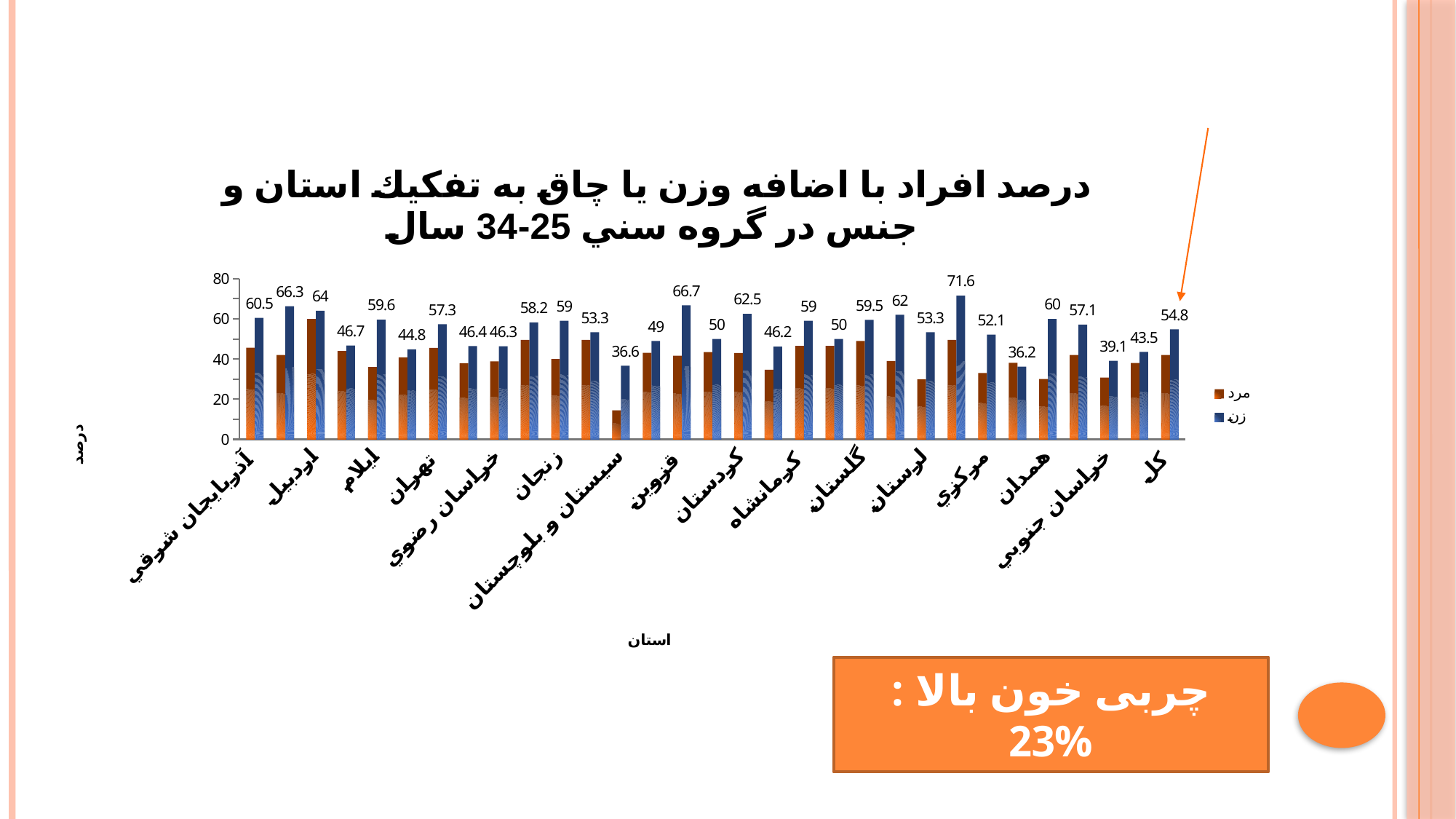
What is the highest data label shown on the chart? 71.6 What kind of chart is shown on the slide? bar chart How many series does the legend list? 2 What is the lowest data label shown on the chart? 36.2 Is the value for مرد in the کل category greater or less than 60? less What is the labelled value for زن in the آذربایجان شرقی category? 60.5 What is the maximum value shown on the vertical axis? 80 What is the difference between the highest labelled value (71.6) and the lowest labelled value (36.2)? 35.4 In the کل category, which series has the larger value, مرد or زن? زن What is the labelled value for زن in the کل category? 54.8 What are the two series named in the legend? مرد and زن What is the difference between the زن value for آذربایجان شرقی and the زن value for کل? 5.7